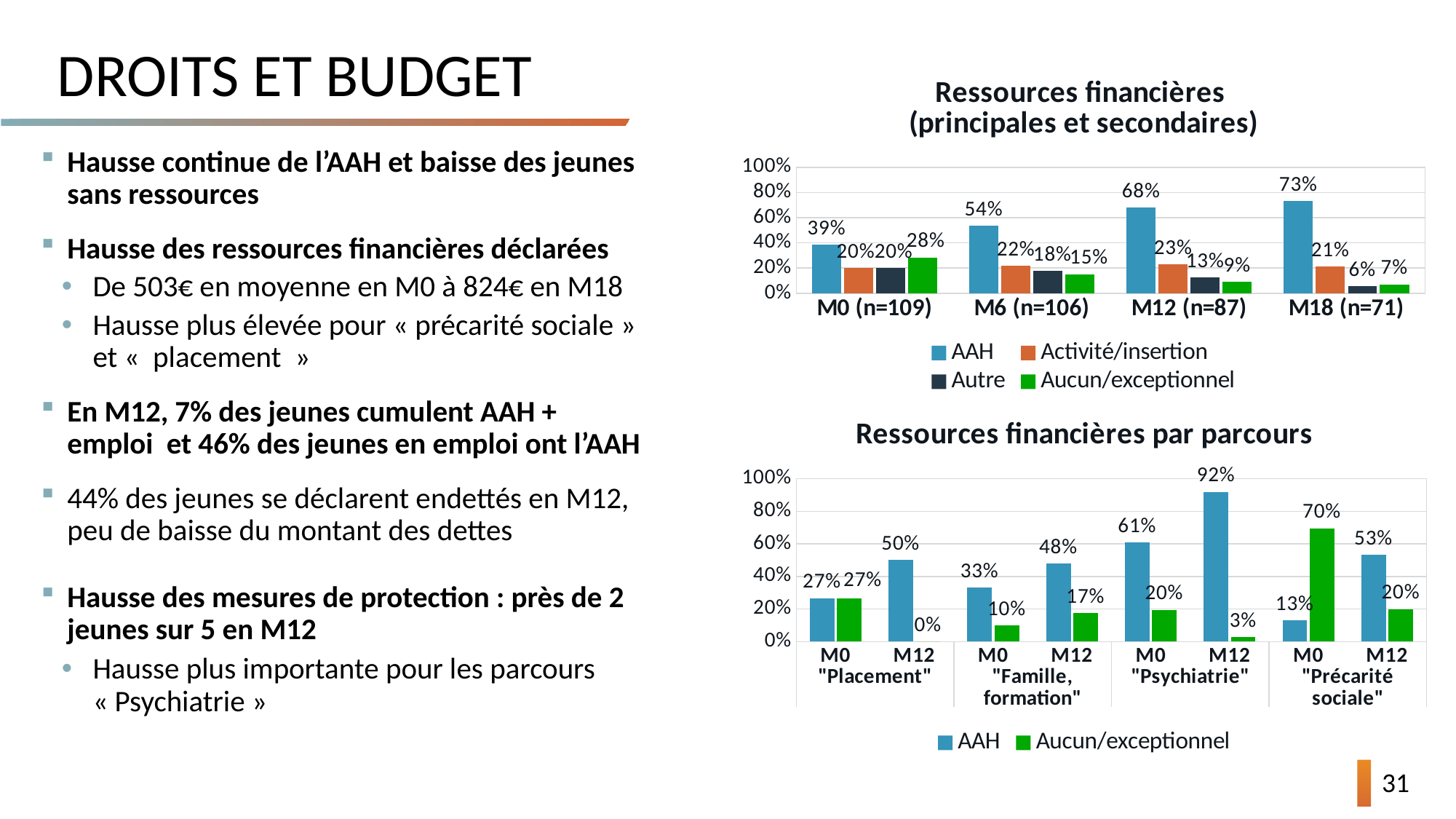
In the chart 'Ressources financières par parcours', what is the AAH value for M12 'Psychiatrie'? 92% In the chart 'Ressources financières (principales et secondaires)', what is the Aucun/exceptionnel value for M0 (n=109)? 28% In the chart 'Ressources financières (principales et secondaires)', what is the AAH value for M18 (n=71)? 73% In the chart 'Ressources financières par parcours', which is larger: the AAH value for M12 'Placement' or the AAH value for M12 'Famille, formation'? M12 "Placement" In the chart 'Ressources financières (principales et secondaires)', how many series does the legend list? 4 In the chart 'Ressources financières (principales et secondaires)', which category has the highest AAH value? M18 (n=71) What kind of chart is 'Ressources financières par parcours'? bar chart In the chart 'Ressources financières par parcours', which category has the lowest Aucun/exceptionnel value? M12 "Placement" In the chart 'Ressources financières (principales et secondaires)', does the AAH value rise or fall from M0 to M18? rise In the chart 'Ressources financières par parcours', what is the difference between the AAH values for M12 'Précarité sociale' and M0 'Précarité sociale'? 40% In the chart 'Ressources financières (principales et secondaires)', what is the difference between the AAH values for M12 (n=87) and M0 (n=109)? 29% In the chart 'Ressources financières par parcours', what is the Aucun/exceptionnel value for M0 'Précarité sociale'? 70%